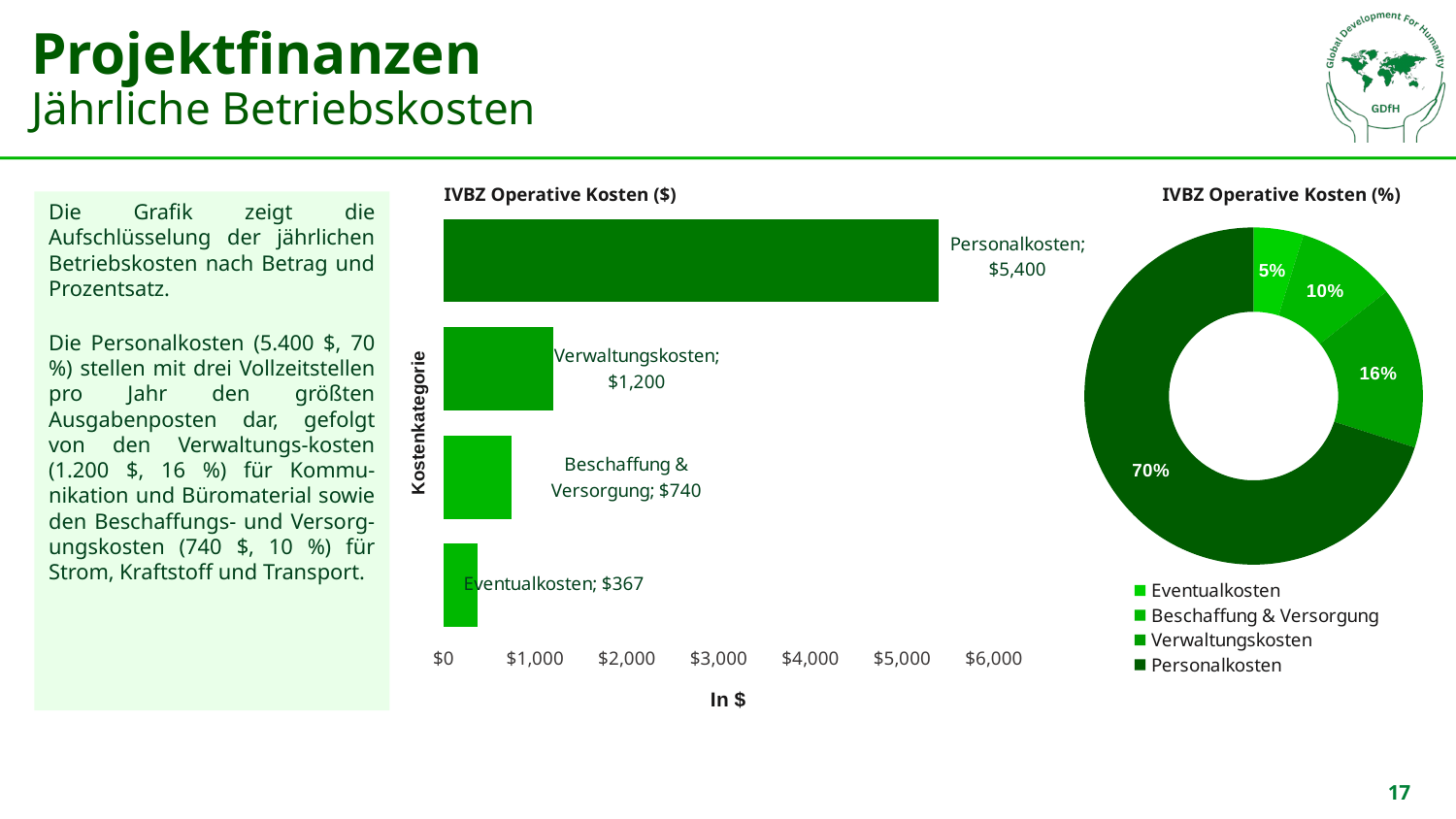
What is the x-axis title of the chart titled 'IVBZ Operative Kosten ($)'? In $ What kind of chart is the one titled 'IVBZ Operative Kosten ($)'? Bar chart In the chart titled 'IVBZ Operative Kosten (%)', what share does Personalkosten have? 70% In the chart titled 'IVBZ Operative Kosten ($)', how many categories are shown? 4 How many entries does the legend of the chart titled 'IVBZ Operative Kosten (%)' list? 4 In the chart titled 'IVBZ Operative Kosten ($)', what is the value for Personalkosten? $5,400 In the chart titled 'IVBZ Operative Kosten ($)', which is larger: Beschaffung & Versorgung or Eventualkosten? Beschaffung & Versorgung In the chart titled 'IVBZ Operative Kosten ($)', what is the value for Verwaltungskosten? $1,200 In the chart titled 'IVBZ Operative Kosten ($)', what is the value for Eventualkosten? $367 In the chart titled 'IVBZ Operative Kosten ($)', which category has the highest value? Personalkosten In the chart titled 'IVBZ Operative Kosten ($)', what is the difference between Verwaltungskosten and Beschaffung & Versorgung? $460 In the chart titled 'IVBZ Operative Kosten ($)', which category has the lowest value? Eventualkosten